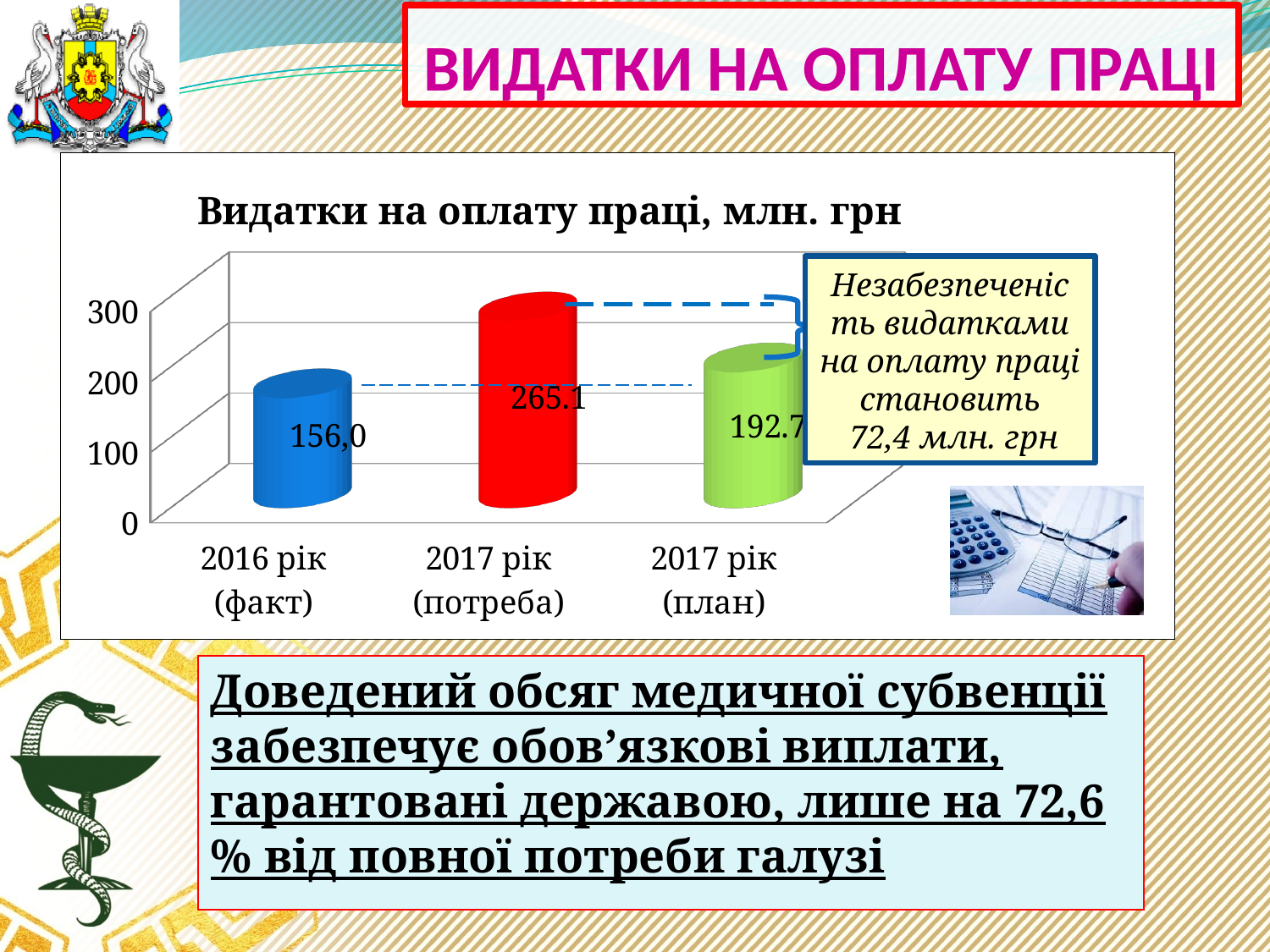
Is the value for 2017 рік (потреба) greater or less than 200? greater Which is larger, the value for 2017 рік (план) or the value for 2016 рік (факт)? 2017 рік (план) What is the value for 2017 рік (план)? 192.7 What is the value for 2016 рік (факт)? 156,0 Which category has the highest value? 2017 рік (потреба) What type of chart is shown on the slide? bar chart Which category has the lowest value? 2016 рік (факт) What is the value for 2017 рік (потреба)? 265.1 What is the difference between the values for 2017 рік (план) and 2016 рік (факт)? 36.7 What is the title of the chart? Видатки на оплату праці, млн. грн How many categories are plotted in the chart? 3 What is the difference between the values for 2017 рік (потреба) and 2017 рік (план)? 72.4